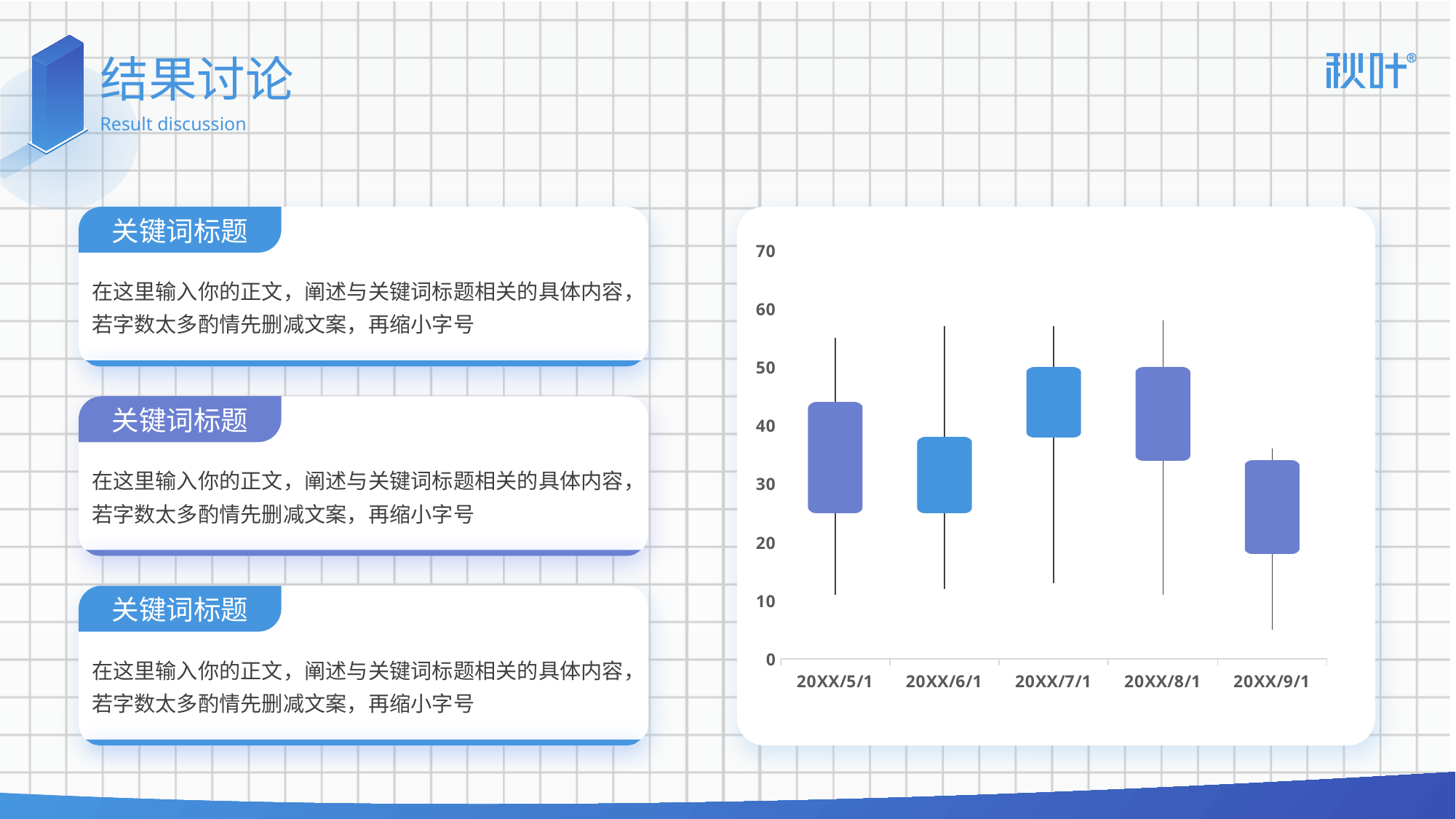
Is the bottom of the box for 20XX/5/1 greater or less than 30? less Is the bottom of the box for 20XX/7/1 greater or less than 30? greater What is the highest tick value shown on the y axis of the chart? 70 What kind of chart is shown on the slide? Stock (candlestick) chart How many dates are plotted along the x axis of the chart? 5 Which date has the lowest bottom of its box in the chart? 20XX/9/1 Is the highest point of the line for 20XX/5/1 greater or less than 50? greater What is the first category label on the x axis of the chart? 20XX/5/1 Which has the higher top of its box, 20XX/5/1 or 20XX/9/1? 20XX/5/1 Which date has the lowest low (bottom of the line) in the chart? 20XX/9/1